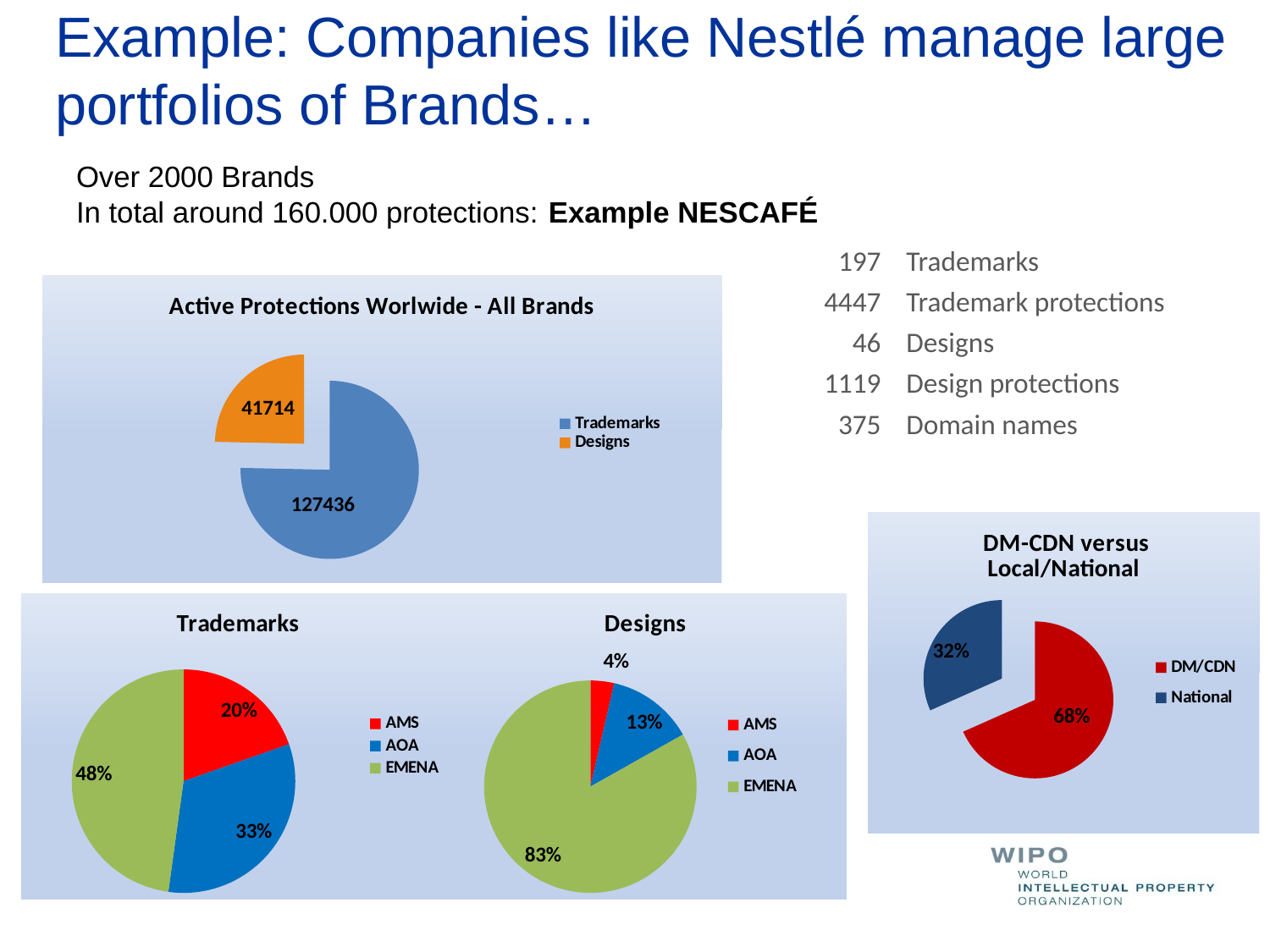
In the 'Active Protections Worlwide - All Brands' chart, what is the difference between the Trademarks and Designs values? 85722 In the 'DM-CDN versus Local/National' chart, what share does National have? 32% In the 'Designs' pie chart, what is the difference between the AOA and AMS shares? 9% In the 'Designs' pie chart, what share does EMENA have? 83% In the 'Trademarks' pie chart, which region has the smallest share? AMS In the 'Active Protections Worlwide - All Brands' chart, what is the value for Trademarks? 127436 What kind of chart is 'Active Protections Worlwide - All Brands'? Pie chart In the 'Trademarks' pie chart, what share does AOA have? 33% In the 'Active Protections Worlwide - All Brands' chart, what is the value for Designs? 41714 In the 'Designs' pie chart, which region has the smallest share? AMS How many entries does the legend of the 'DM-CDN versus Local/National' chart list? 2 In the 'Trademarks' pie chart, what share does EMENA have? 48%